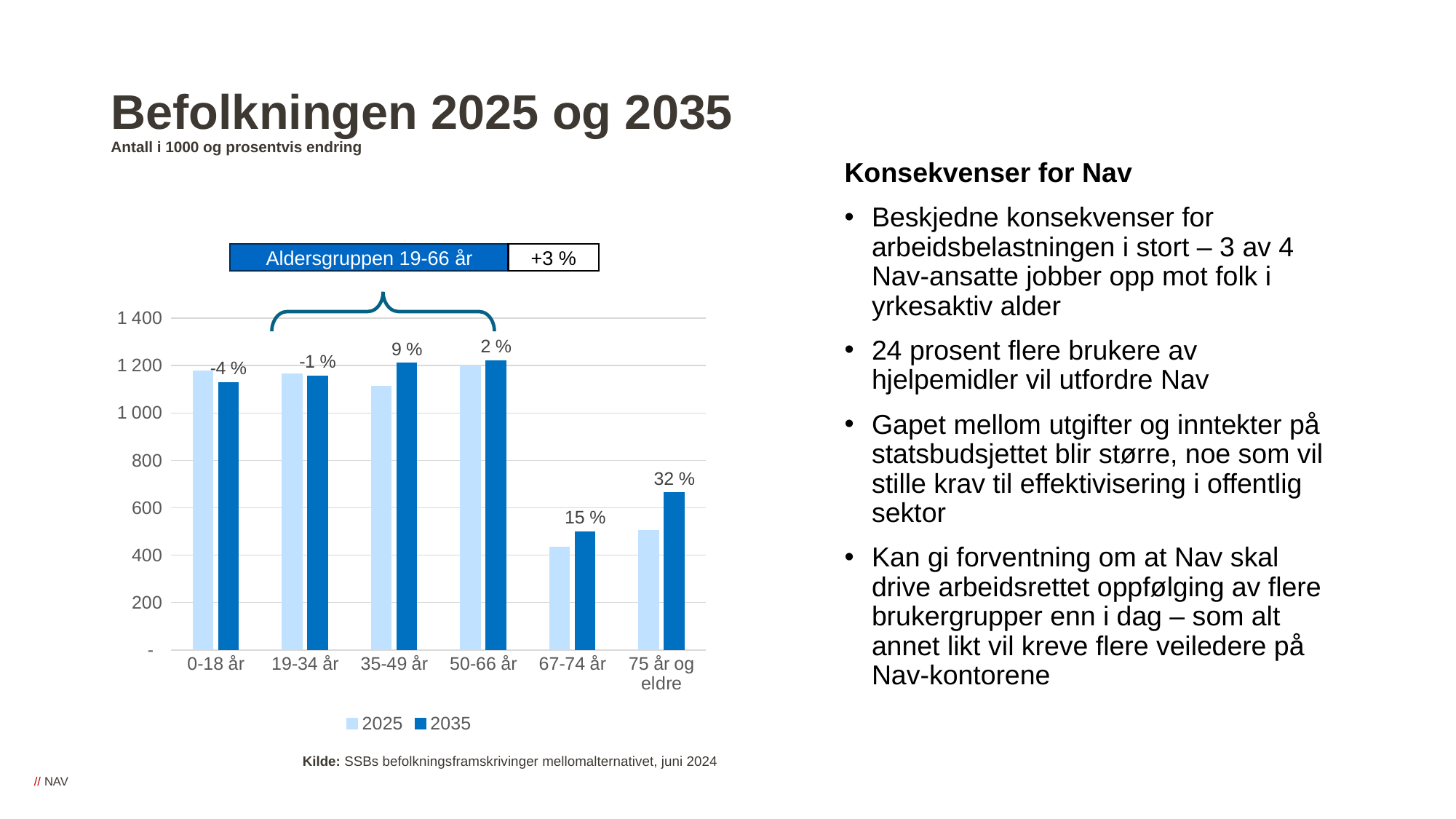
Is the 2035 value for 75 år og eldre greater or less than 600? greater Is the 2025 value for 67-74 år greater or less than 600? less What percentage change is labelled for the 35-49 år age group? 9 % Which is larger: the 2035 value for 67-74 år or the 2035 value for 75 år og eldre? 75 år og eldre Is the 2025 value for 0-18 år greater or less than 1 000? greater What percentage change is labelled for the 75 år og eldre age group? 32 % How many age groups are shown on the x axis? 6 Which age group has the lowest labelled percentage change? 0-18 år Which age group has the highest labelled percentage change? 75 år og eldre What percentage change is labelled for the 0-18 år age group? -4 % How many series does the legend list? 2 What percentage change is shown in the box for Aldersgruppen 19-66 år? +3 %